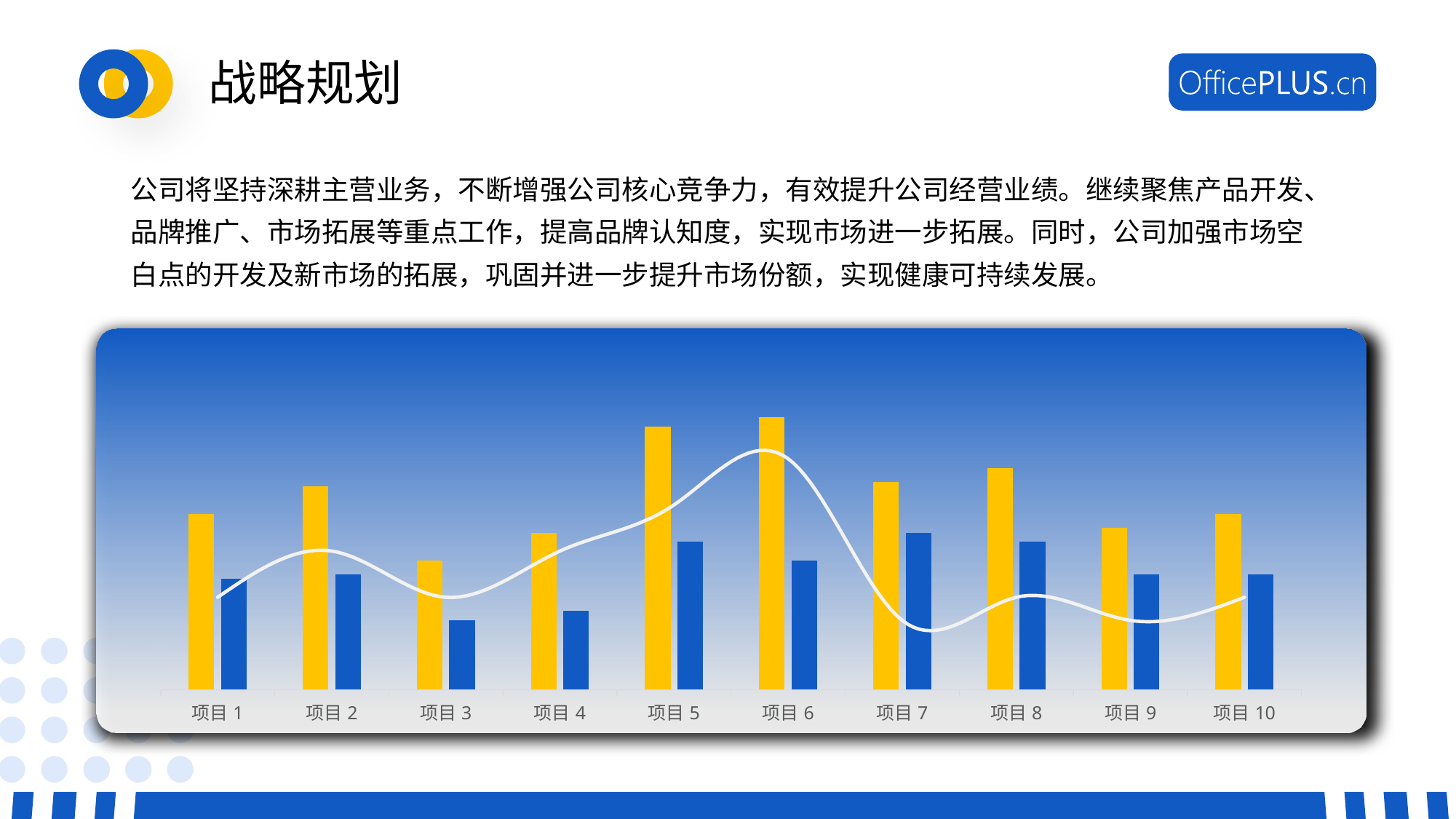
What two colours are used for the bars in the chart? yellow and blue Is the yellow bar for 项目 5 taller or shorter than the yellow bar for 项目 1? taller Is the blue bar for 项目 7 taller or shorter than the blue bar for 项目 3? taller What kind of chart is shown on the slide? bar chart with a line How many categories are shown on the x axis of the chart? 10 Is the yellow bar for 项目 2 taller or shorter than the yellow bar for 项目 4? taller What is the label of the first category on the x axis? 项目 1 Does the white line rise or fall from 项目 6 to 项目 7? fall Does the white line rise or fall from 项目 4 to 项目 6? rise Which category has the tallest yellow bar? 项目 6 Which category has the shortest yellow bar? 项目 3